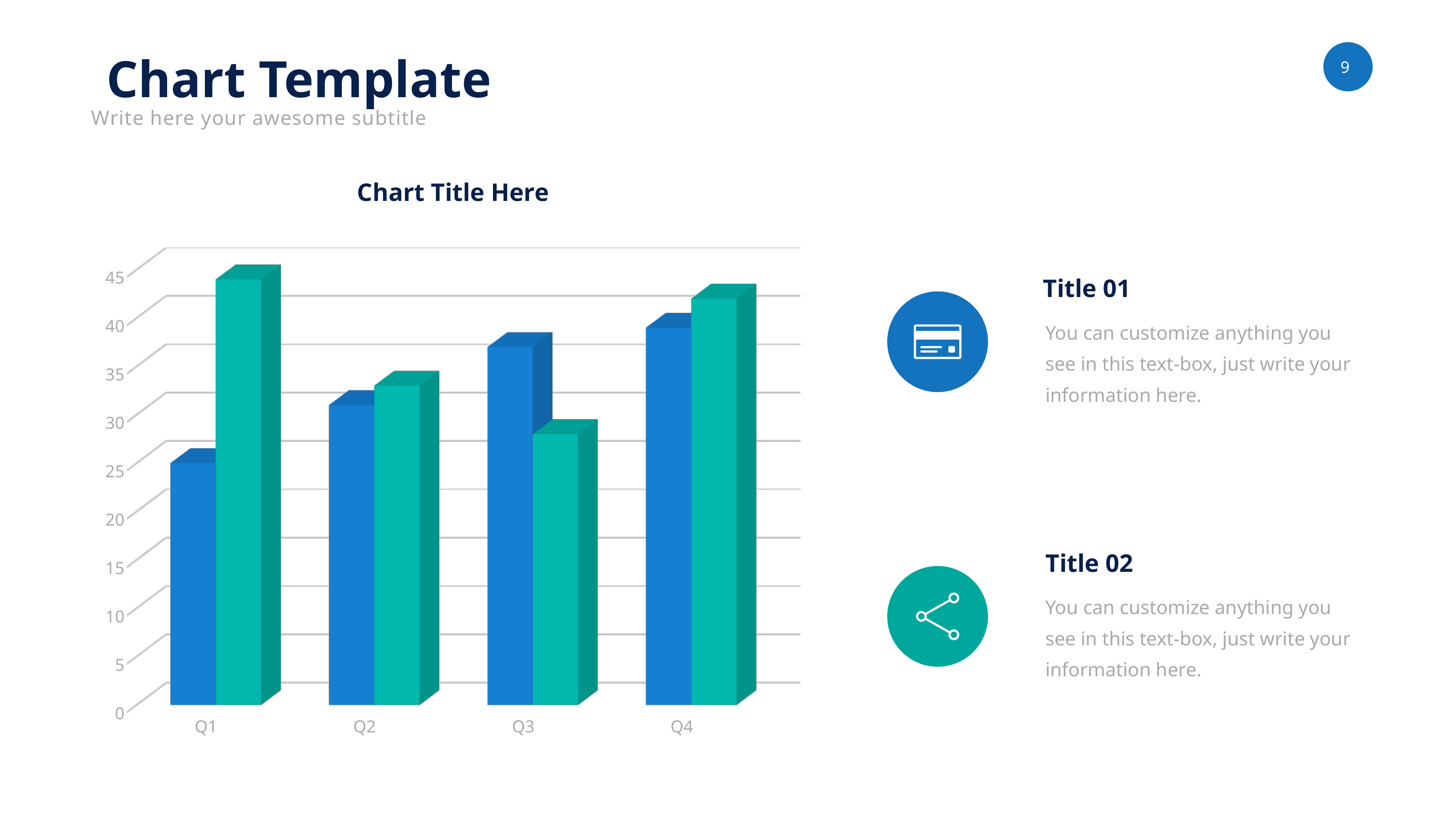
For Q3, which bar is taller, the blue one or the teal one? The blue one Is the value of the blue bar for Q4 greater or less than 35? greater What kind of chart is shown on the slide? Bar chart Do the blue bars rise or fall from Q1 to Q4? Rise For Q1, which bar is taller, the blue one or the teal one? The teal one Which quarter has the shortest blue bar? Q1 Is the value of the teal bar for Q3 greater or less than 35? less What is the title of the chart? Chart Title Here How many categories are shown on the x axis of the chart? 4 Which quarter has the tallest teal bar? Q1 Is the value of the teal bar for Q1 greater or less than 40? greater